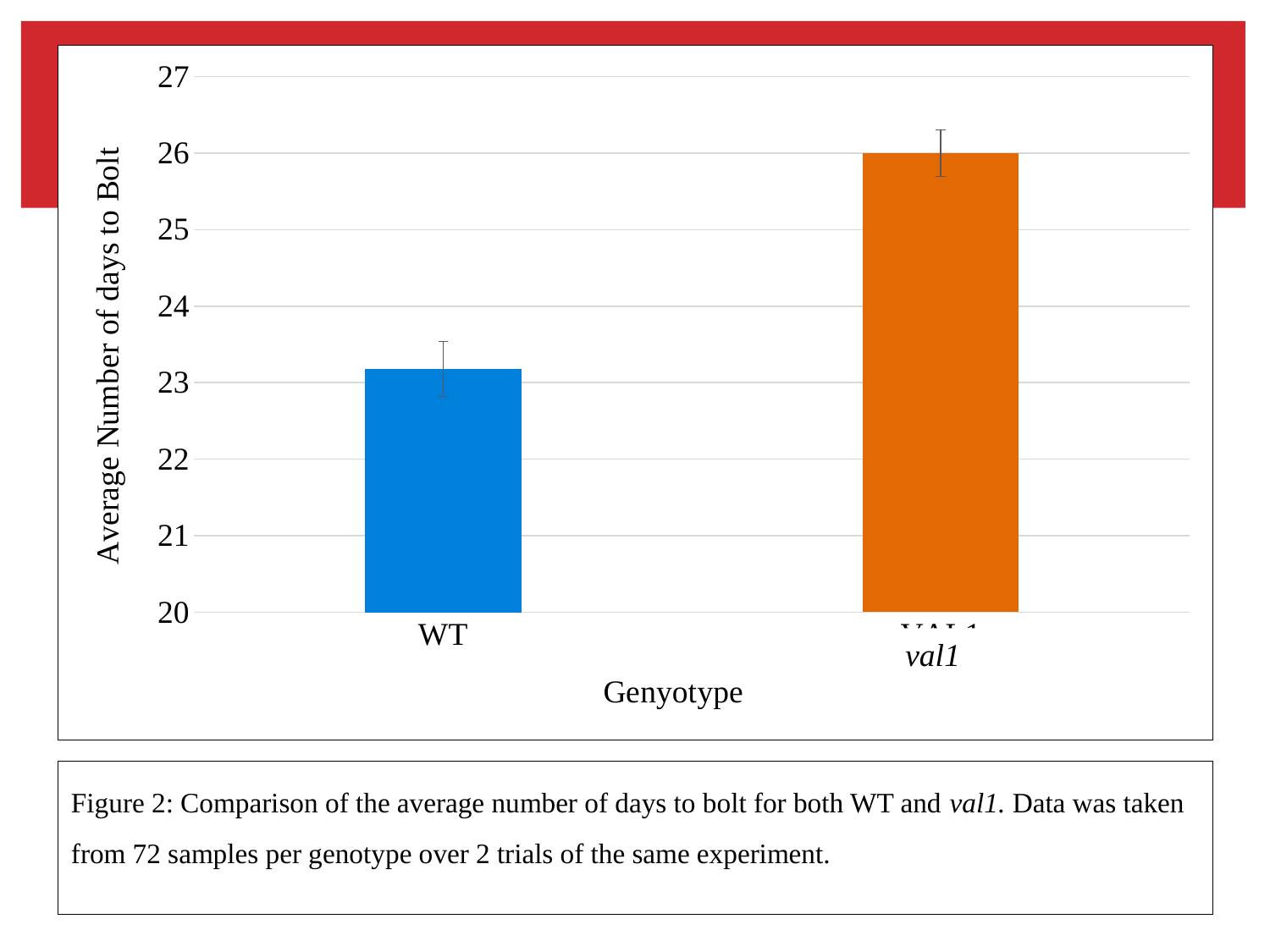
What kind of chart is shown on the slide? bar chart How many genotypes (bars) are plotted in the chart? 2 What is the label of the x axis? Genyotype Is the value for val1 greater or less than 25? greater What is the label of the y axis? Average Number of days to Bolt Do the values rise or fall moving from WT to val1 along the x axis? rise Which genotype has the lower average number of days to bolt? WT Is the value for WT greater or less than 24? less Which genotype has the higher average number of days to bolt? val1 What is the average number of days to bolt for val1? 26 Is the average number of days to bolt larger for WT or for val1? val1 Is the value for WT greater or less than 23? greater